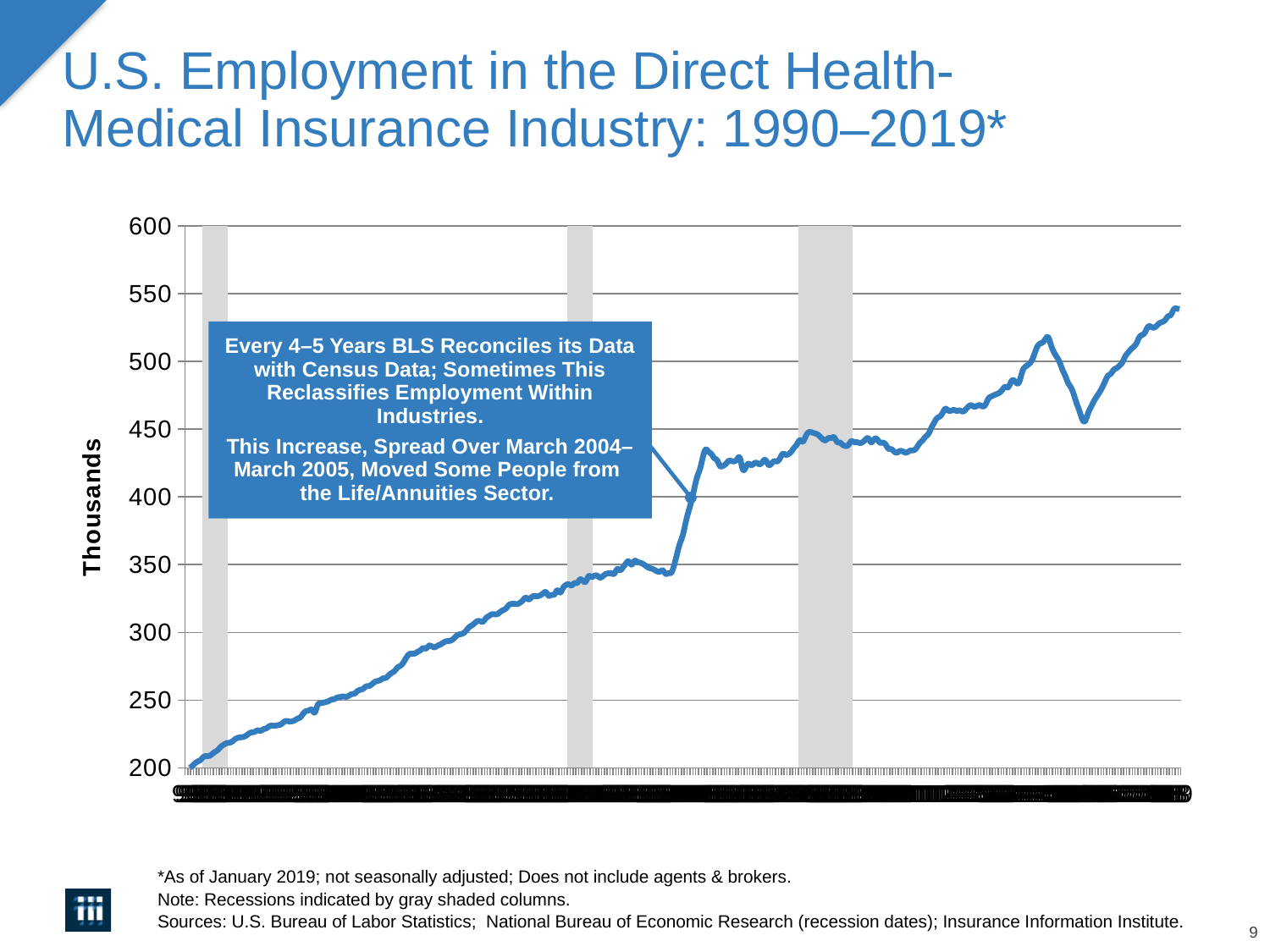
Overall, do the values rise or fall from 1990 to 2019 along the x axis? rise Is the value at the end of the series (January 2019) greater or less than 500? greater What is the label on the vertical axis? Thousands What kind of chart is shown on the slide? line chart Immediately after the March 2004–March 2005 increase noted in the callout, is the value greater or less than 400? greater At which end of the series does the line reach its lowest value? the start (1990) Is the value just before the March 2004–March 2005 increase greater or less than 400? less How many gray shaded recession columns appear on the chart? 3 At which end of the series does the line reach its highest value? the end (2019)